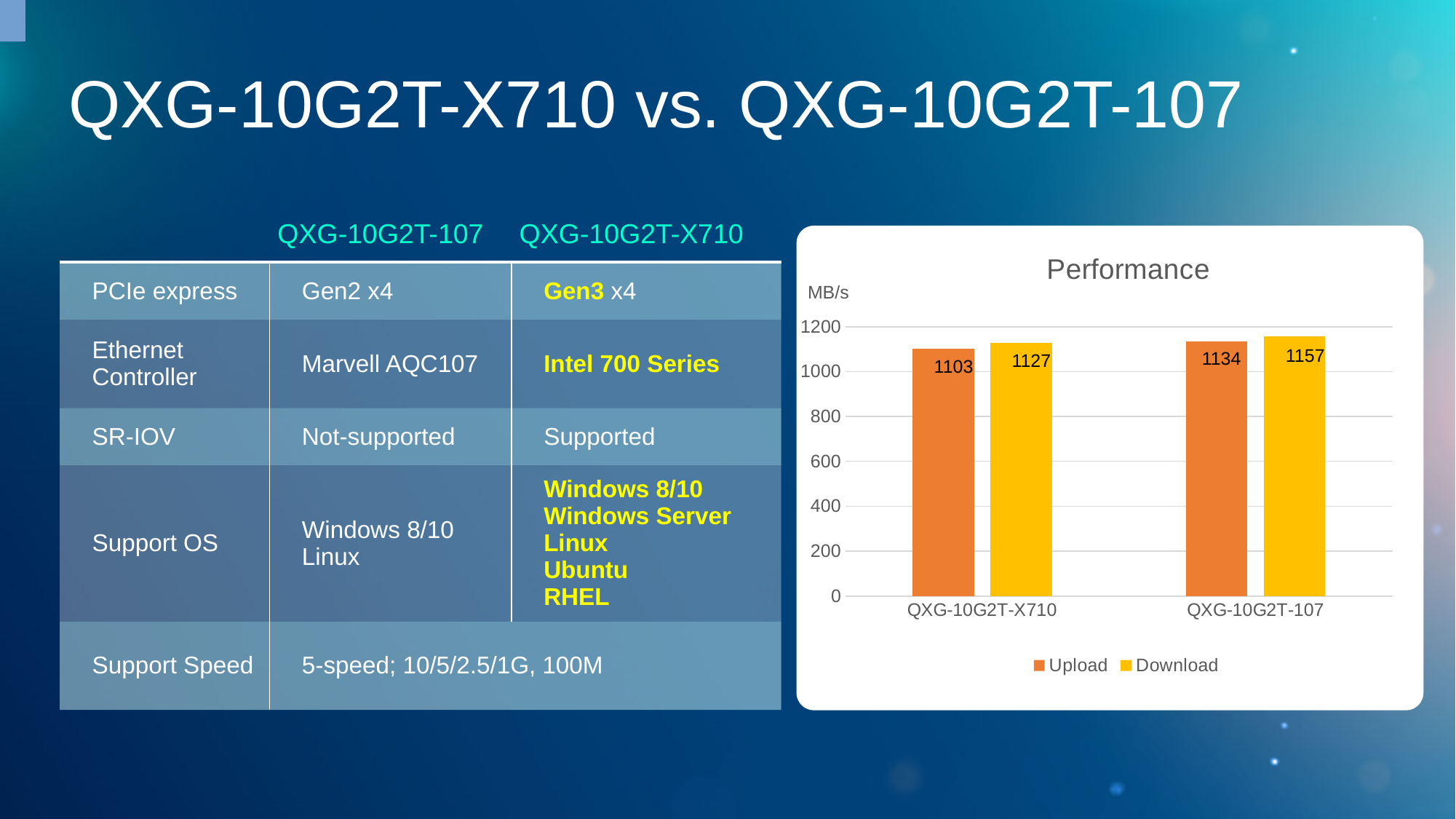
How many categories are shown on the x axis of the Performance chart? 2 What is the difference between the Upload values of QXG-10G2T-107 and QXG-10G2T-X710 in the Performance chart? 31 What is the Download value for QXG-10G2T-107 in the Performance chart? 1157 Which category has the lowest Upload value in the Performance chart? QXG-10G2T-X710 Which category has the highest Download value in the Performance chart? QXG-10G2T-107 What unit is shown on the y axis of the Performance chart? MB/s What kind of chart is the Performance chart? bar chart What is the Upload value for QXG-10G2T-X710 in the Performance chart? 1103 What is the difference between the Download values of QXG-10G2T-107 and QXG-10G2T-X710 in the Performance chart? 30 What is the Upload value for QXG-10G2T-107 in the Performance chart? 1134 How many series does the legend of the Performance chart list? 2 What is the Download value for QXG-10G2T-X710 in the Performance chart? 1127